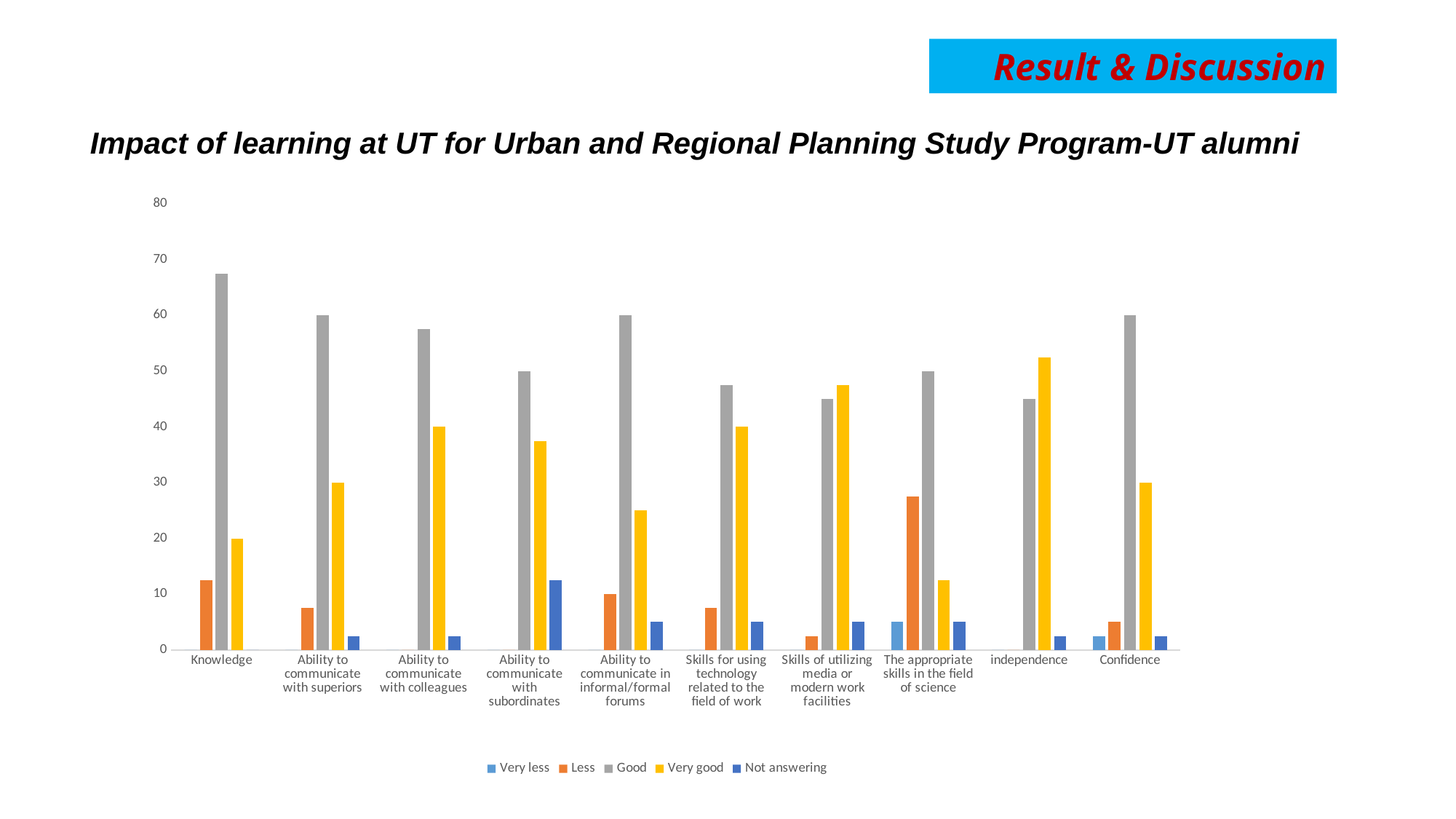
Which category has the highest value for the Good series? Knowledge What is the title of the chart? Impact of learning at UT for Urban and Regional Planning Study Program-UT alumni Is the Good value for Knowledge greater or less than 60? greater For Confidence, which is larger: the Good value or the Very good value? Good Which category has the highest value for the Very good series? independence How many categories are shown along the x axis of the chart? 10 What kind of chart is shown on the slide? bar chart Which category has the highest value for the Less series? The appropriate skills in the field of science How many series does the chart's legend list? 5 Is the Less value for The appropriate skills in the field of science greater or less than 20? greater Is the Very good value for Knowledge greater or less than 30? less For independence, which is larger: the Good value or the Very good value? Very good